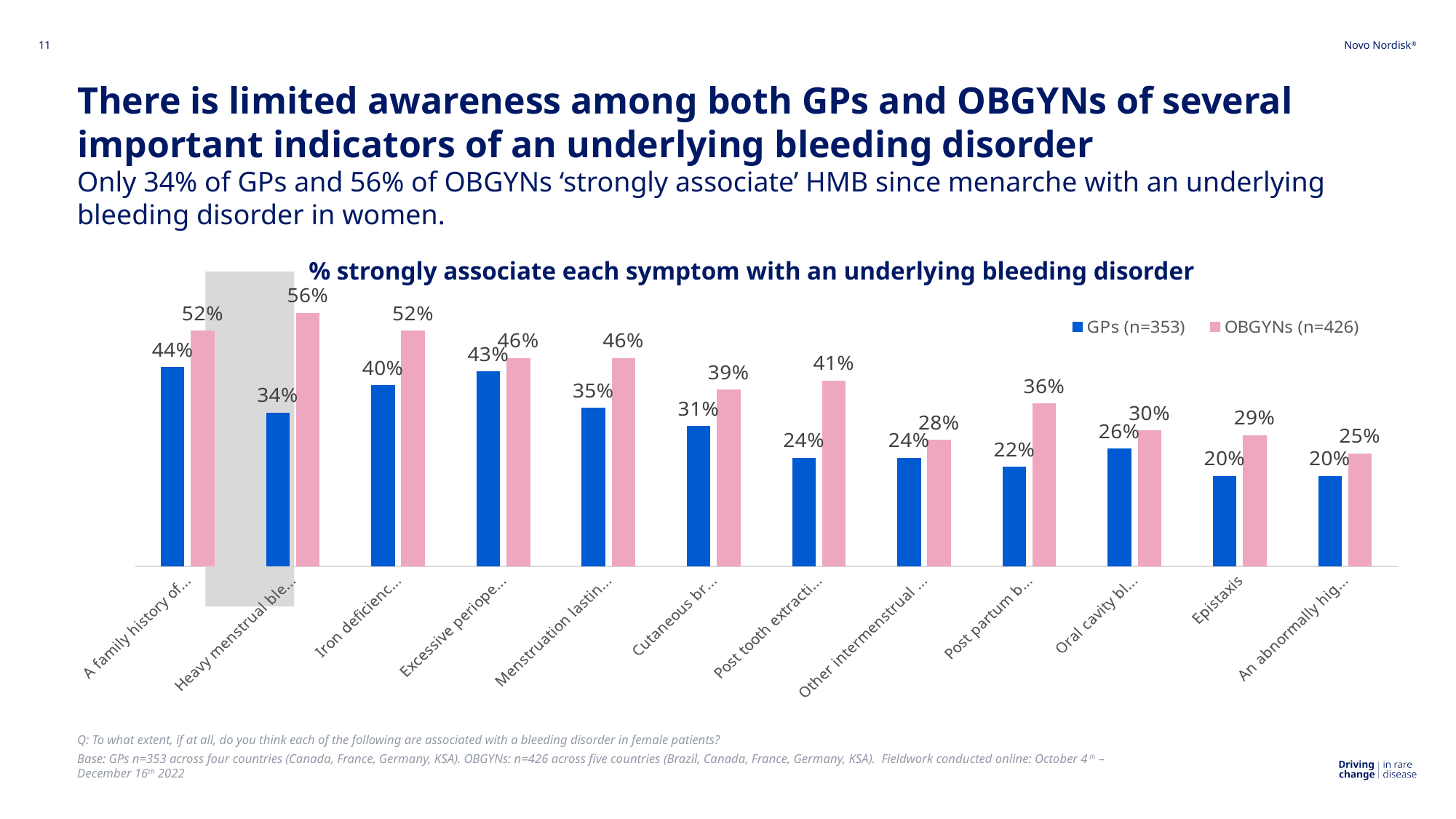
What percentage of OBGYNs strongly associate epistaxis with an underlying bleeding disorder? 29% What is the difference between the OBGYNs and GPs values for epistaxis? 9% For the category labelled 'Iron deficienc...', which is larger: the GPs value or the OBGYNs value? OBGYNs What is the GPs value for the category labelled 'Post partum b...'? 22% What type of chart is shown on the slide? Bar chart How many symptom categories are shown on the x axis of the chart? 12 Which category has the highest OBGYNs value? Heavy menstrual ble... Which category has the highest GPs value? A family history of... What is the difference between the OBGYNs and GPs values for the category labelled 'Post tooth extracti...'? 17% What percentage of GPs strongly associate epistaxis with an underlying bleeding disorder? 20% What is the OBGYNs value for the category labelled 'Heavy menstrual ble...'? 56% How many series does the chart legend list? 2